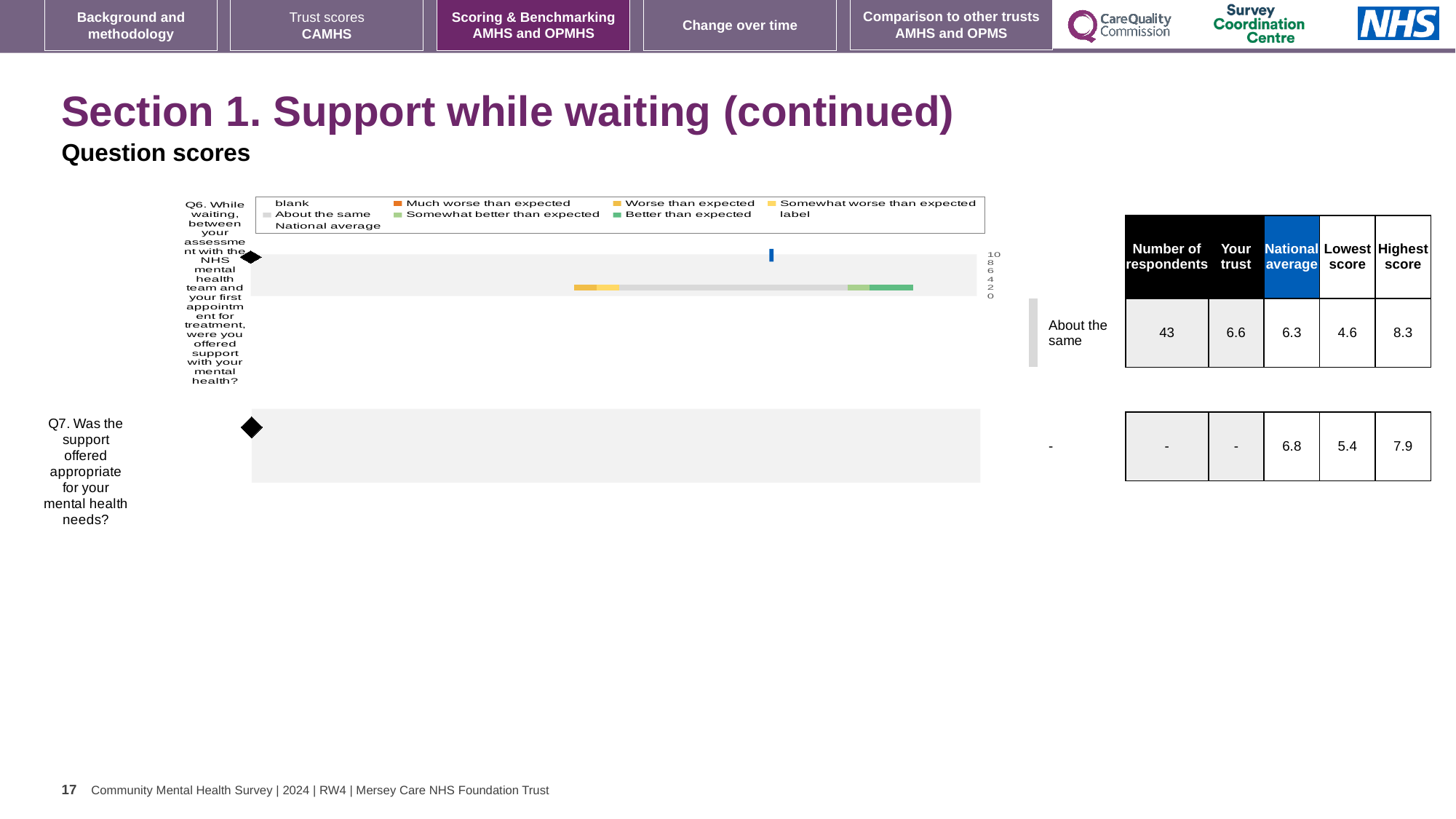
What comparison category is shown next to the Q6 bar? About the same In the table beside the chart, what is the number of respondents for Q6? 43 For Q6, which is larger: the 'Your trust' score or the national average? Your trust In the table beside the chart, what is the 'Your trust' score for Q6? 6.6 In the table beside the chart, what is the national average for Q7? 6.8 Which colour in the chart legend represents 'Better than expected'? green How many questions are plotted in the chart? 2 What kind of chart is used to show the question scores on this slide? bar chart Which colour in the chart legend represents 'Much worse than expected'? orange For Q7, what is the difference between the highest score and the lowest score in the table? 2.5 For Q6, what is the difference between the highest score and the lowest score in the table? 3.7 For Q6, what is the difference between the 'Your trust' score and the national average? 0.3